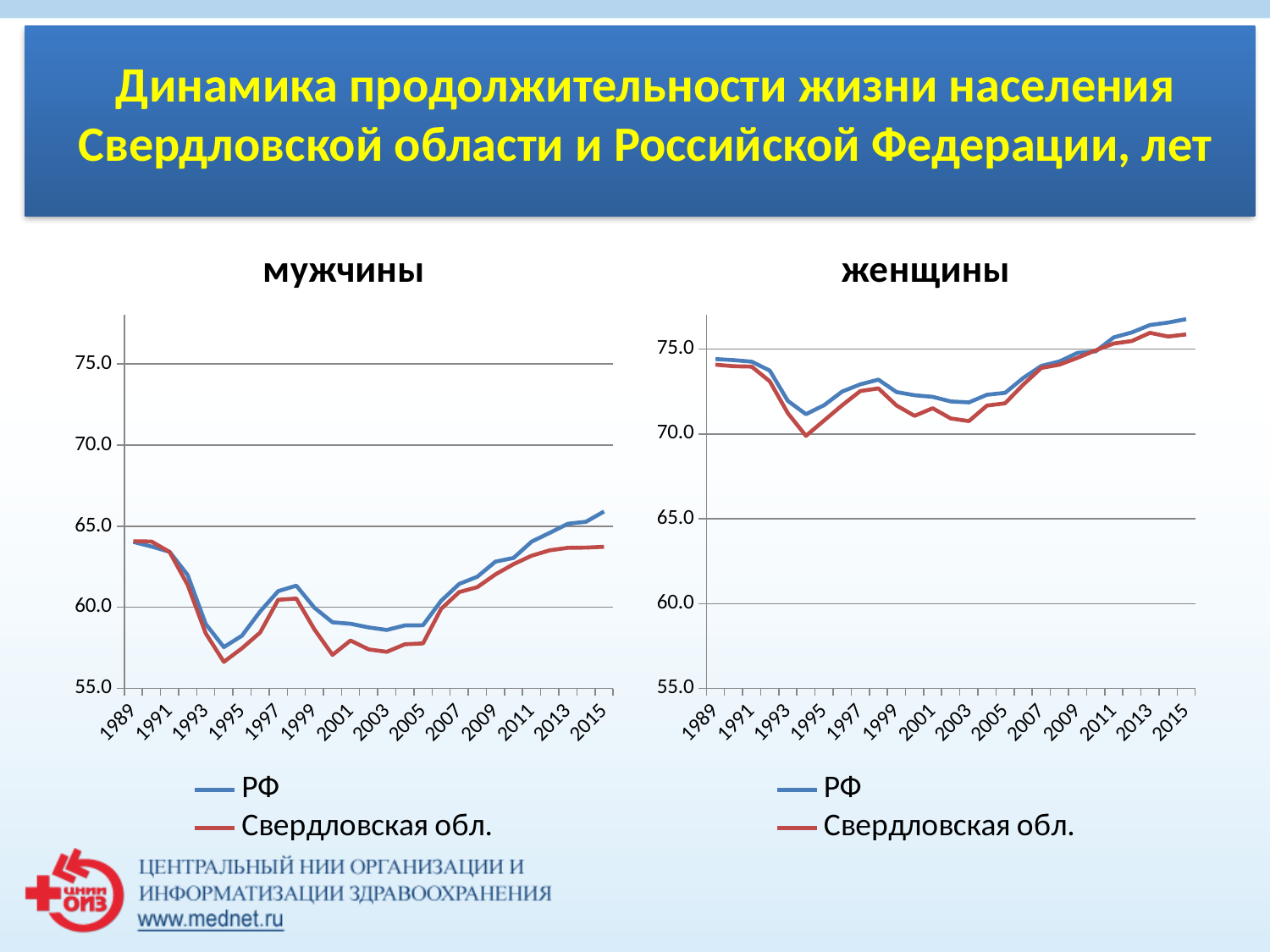
In the "мужчины" chart, do the values for Свердловская обл. rise or fall from 2005 to 2015? rise In the "мужчины" chart, is the value for РФ in 1995 greater or less than 60.0? less In the "мужчины" chart, is the value for Свердловская обл. in 2015 greater or less than 65.0? less Which series is drawn in red in the "мужчины" chart? Свердловская обл. In the "женщины" chart, do the values for РФ rise or fall from 1989 to 1994? fall In the "женщины" chart, is the value for РФ in 2015 greater or less than 75.0? greater In the "мужчины" chart, which series has the higher value in 2015, РФ or Свердловская обл.? РФ In the "женщины" chart, which series has the higher value in 1994, РФ or Свердловская обл.? РФ How many series does the legend of the "женщины" chart list? 2 What kind of chart is the "мужчины" chart? line chart